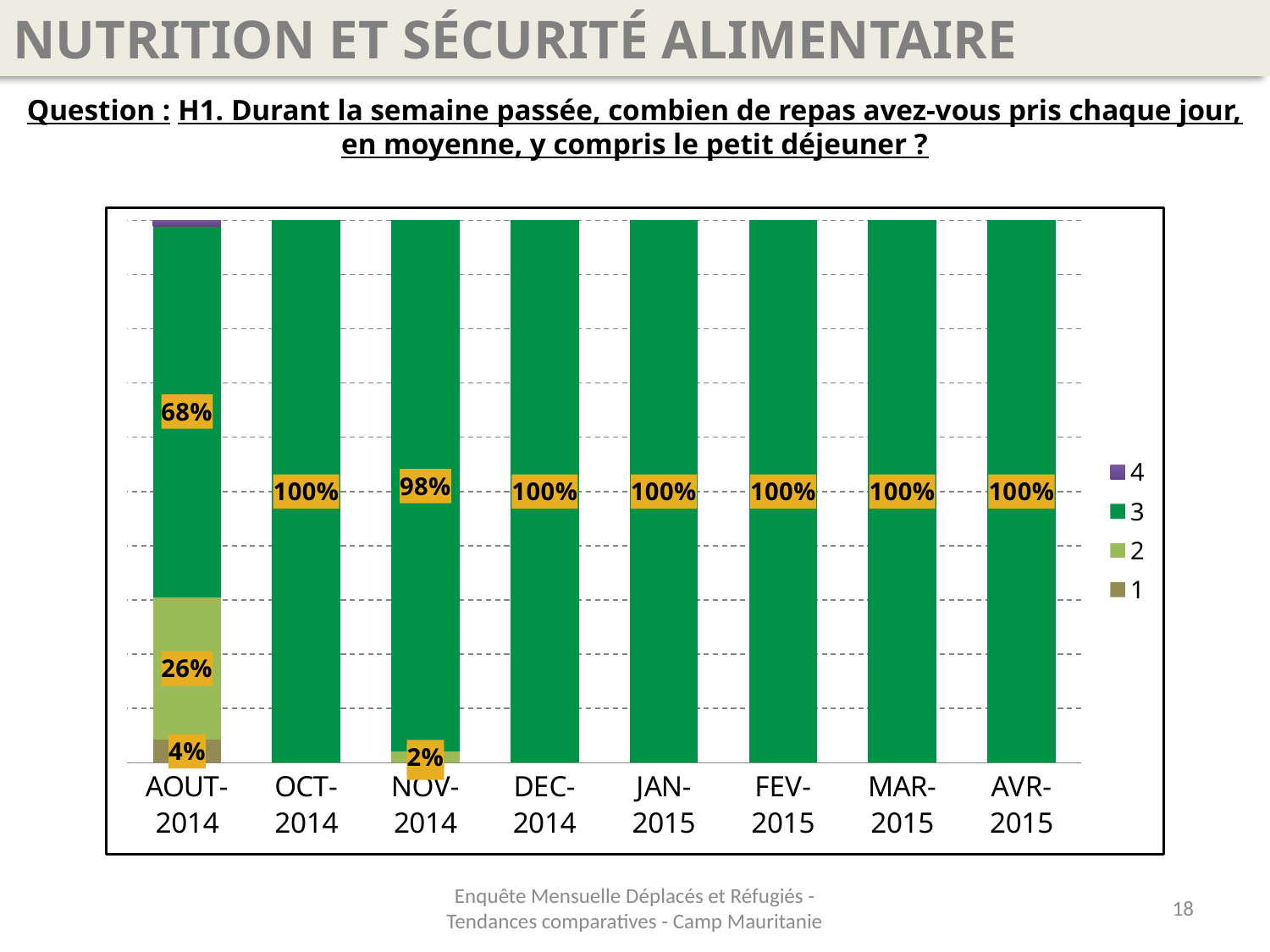
What is the value of series 3 for DEC-2014? 100% What type of chart is shown on the slide? stacked bar chart How many series does the chart legend list? 4 What is the difference between the series 3 value for OCT-2014 and for NOV-2014? 2% Which month has the lowest value for series 3? AOUT-2014 How many months are shown on the x axis of the chart? 8 Which is larger for AOUT-2014: the value of series 2 or the value of series 1? series 2 What is the value of series 2 for NOV-2014? 2% What is the value of series 3 for AOUT-2014? 68% What is the value of series 1 for AOUT-2014? 4% What is the value of series 2 for AOUT-2014? 26% What is the value of series 3 for NOV-2014? 98%